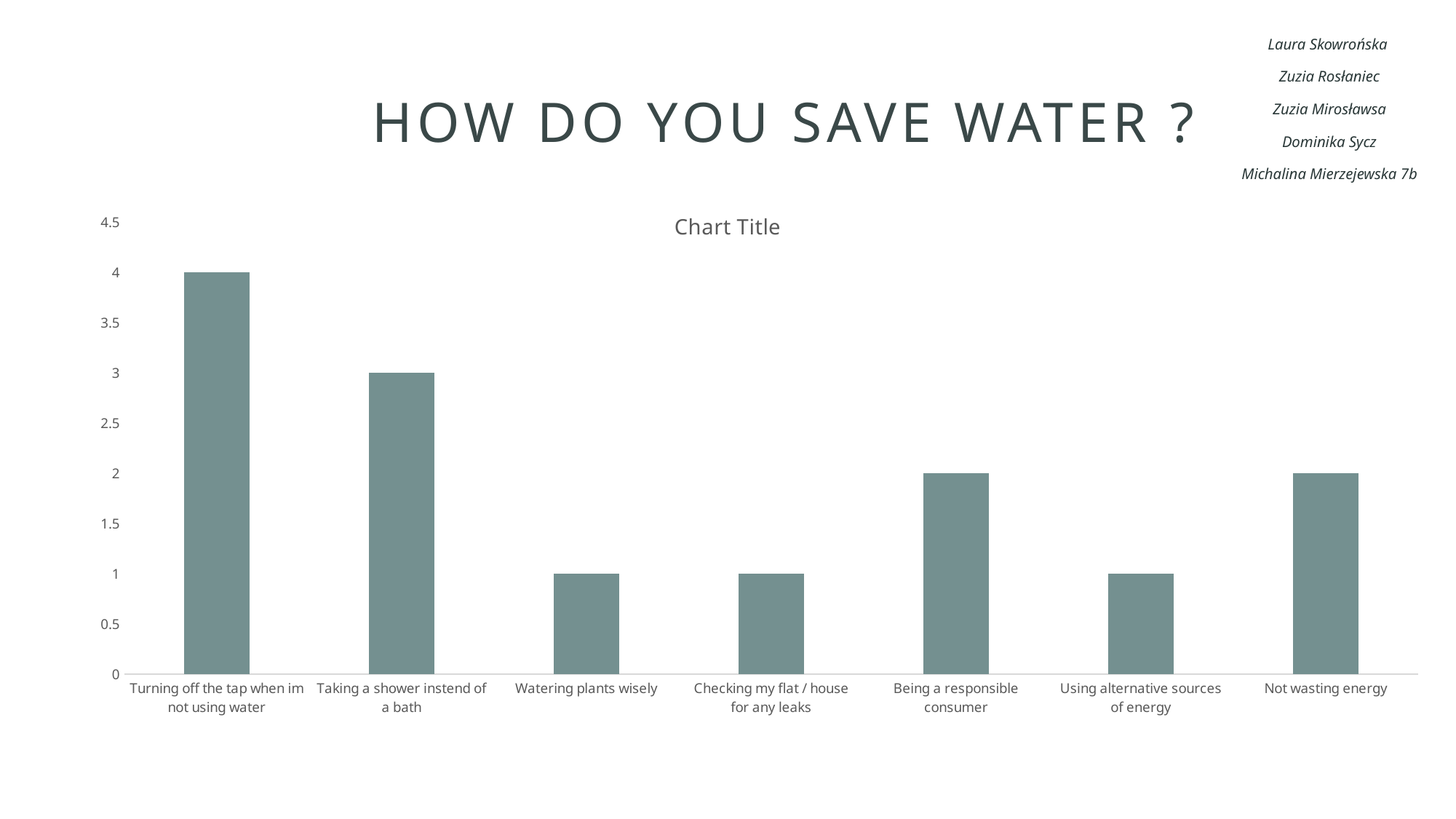
What is the value for "Turning off the tap when im not using water"? 4 What is the difference between the values for "Turning off the tap when im not using water" and "Taking a shower instend of a bath"? 1 What is the value for "Watering plants wisely"? 1 Which is larger, the value for "Not wasting energy" or the value for "Using alternative sources of energy"? Not wasting energy What is the difference between the values for "Being a responsible consumer" and "Checking my flat / house for any leaks"? 1 Is the value for "Taking a shower instend of a bath" greater or less than 2? greater What kind of chart is shown on the slide? bar chart What is the value for "Taking a shower instend of a bath"? 3 What is the value for "Being a responsible consumer"? 2 How many categories are shown on the x axis of the chart? 7 What title is printed above the chart's plot area? Chart Title Which category has the highest value? Turning off the tap when im not using water